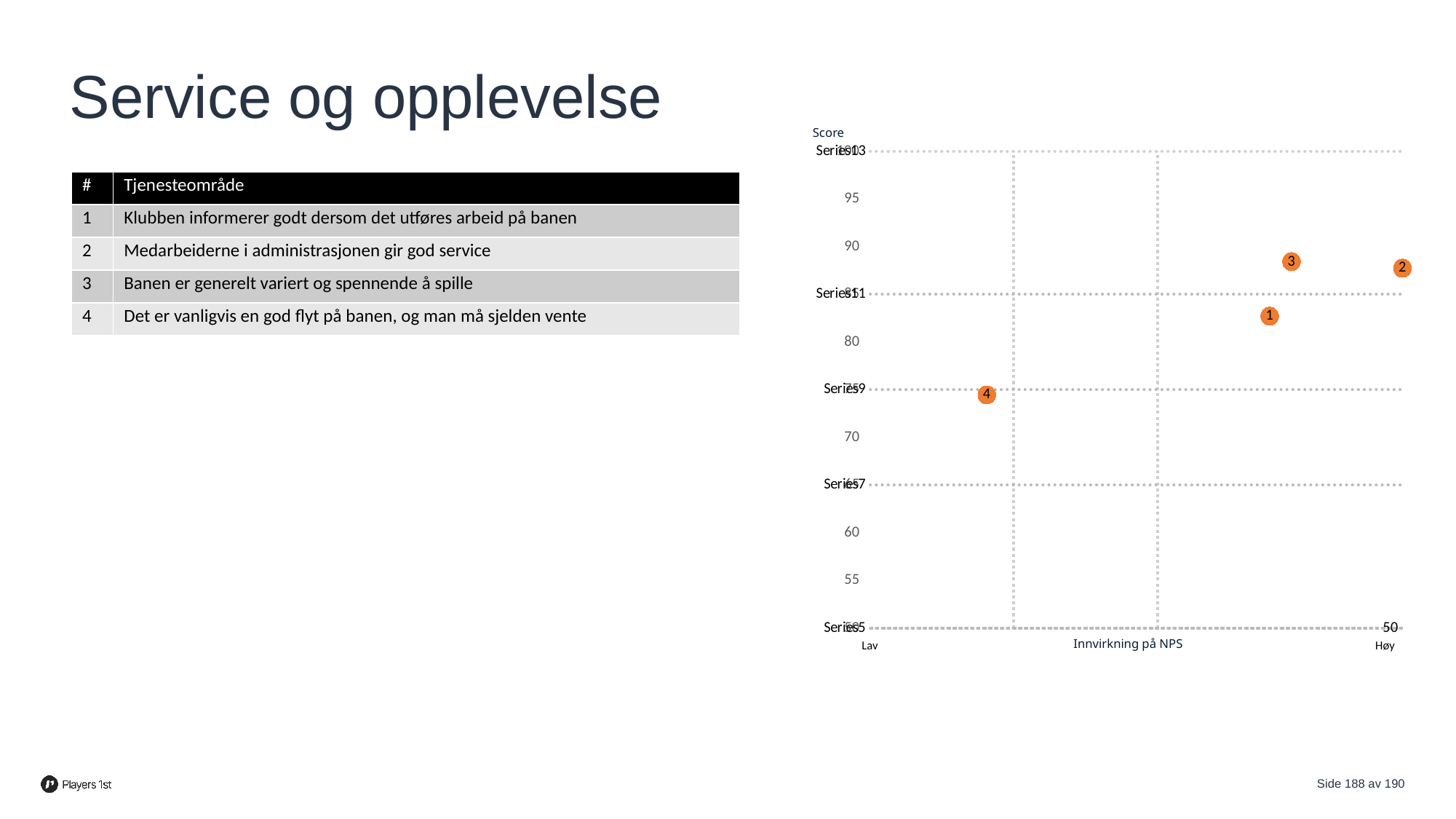
Which point has the lowest score on the chart? 4 Which point lies furthest to the right on the 'Innvirkning på NPS' axis? 2 Is the score for point 1 greater or less than 80? greater How many data points are plotted on the chart? 4 What is the title of the horizontal axis of the chart? Innvirkning på NPS Is the score for point 4 greater or less than 70? greater What is the title of the vertical axis of the chart? Score What kind of chart is shown on the slide? scatter chart Which has the higher score, point 1 or point 4? 1 Which point lies furthest to the left on the 'Innvirkning på NPS' axis? 4 Is the score for point 3 greater or less than 85? greater